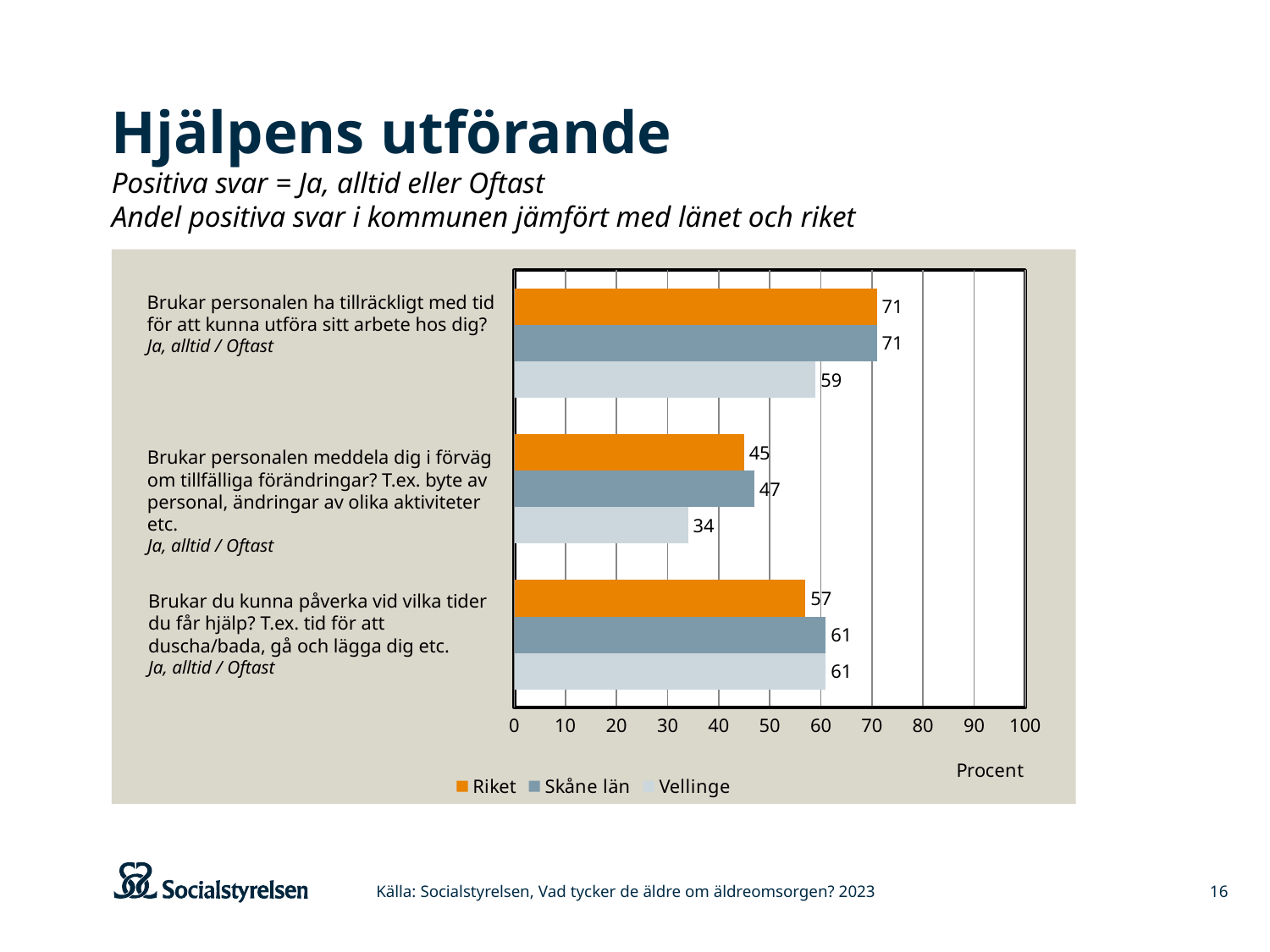
What is the difference between Skåne län and Vellinge on the question "Brukar personalen meddela dig i förväg om tillfälliga förändringar?"? 13 Which series has the lowest value on the question "Brukar personalen meddela dig i förväg om tillfälliga förändringar?"? Vellinge What is the value for Skåne län on the question "Brukar du kunna påverka vid vilka tider du får hjälp?"? 61 What is the label on the horizontal axis of the chart? Procent What is the value for Riket on the question "Brukar personalen meddela dig i förväg om tillfälliga förändringar?"? 45 What is the value for Vellinge on the question "Brukar personalen ha tillräckligt med tid för att kunna utföra sitt arbete hos dig?"? 59 What is the difference between Skåne län and Vellinge on the question "Brukar personalen ha tillräckligt med tid för att kunna utföra sitt arbete hos dig?"? 12 On the question "Brukar du kunna påverka vid vilka tider du får hjälp?", which is larger, Riket or Vellinge? Vellinge How many questions (categories) are shown in the chart? 3 What kind of chart is shown on the slide? Bar chart How many series does the legend list? 3 For Vellinge, which question has the highest value? Brukar du kunna påverka vid vilka tider du får hjälp?